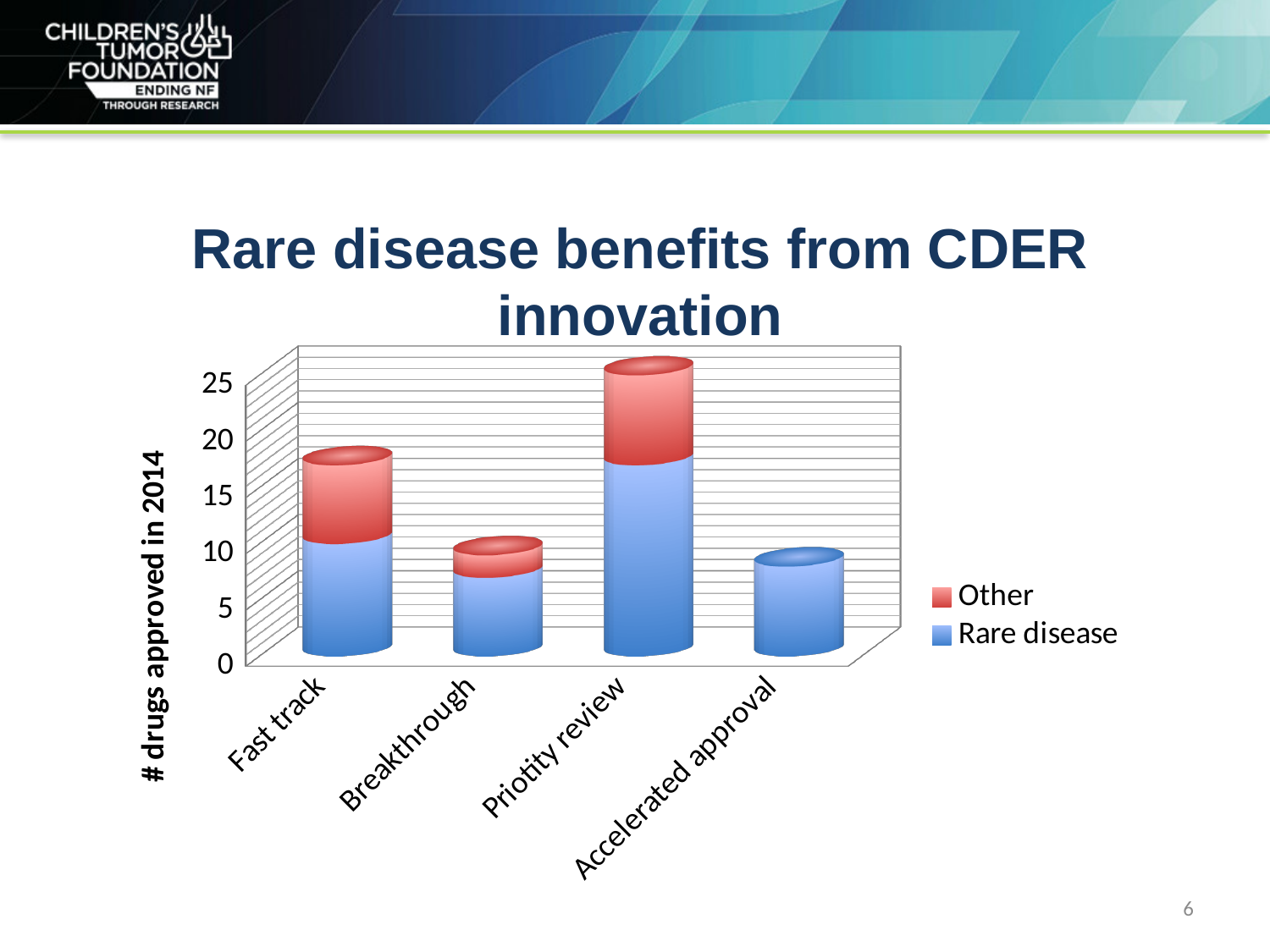
Which category has the tallest Rare disease segment? Priotity review Is the total value for Priotity review greater or less than 20? greater Which colour represents the Other series in the chart? Red Is the total value for Breakthrough greater or less than 15? less Is the Rare disease value for Priotity review greater or less than 10? greater Which category has the highest total number of drugs approved? Priotity review Which has a larger total bar, Fast track or Breakthrough? Fast track What is the title of the chart's vertical axis? # drugs approved in 2014 How many categories are shown on the x axis of the chart? 4 How many series does the chart's legend list? 2 What kind of chart is shown on the slide? Stacked bar chart